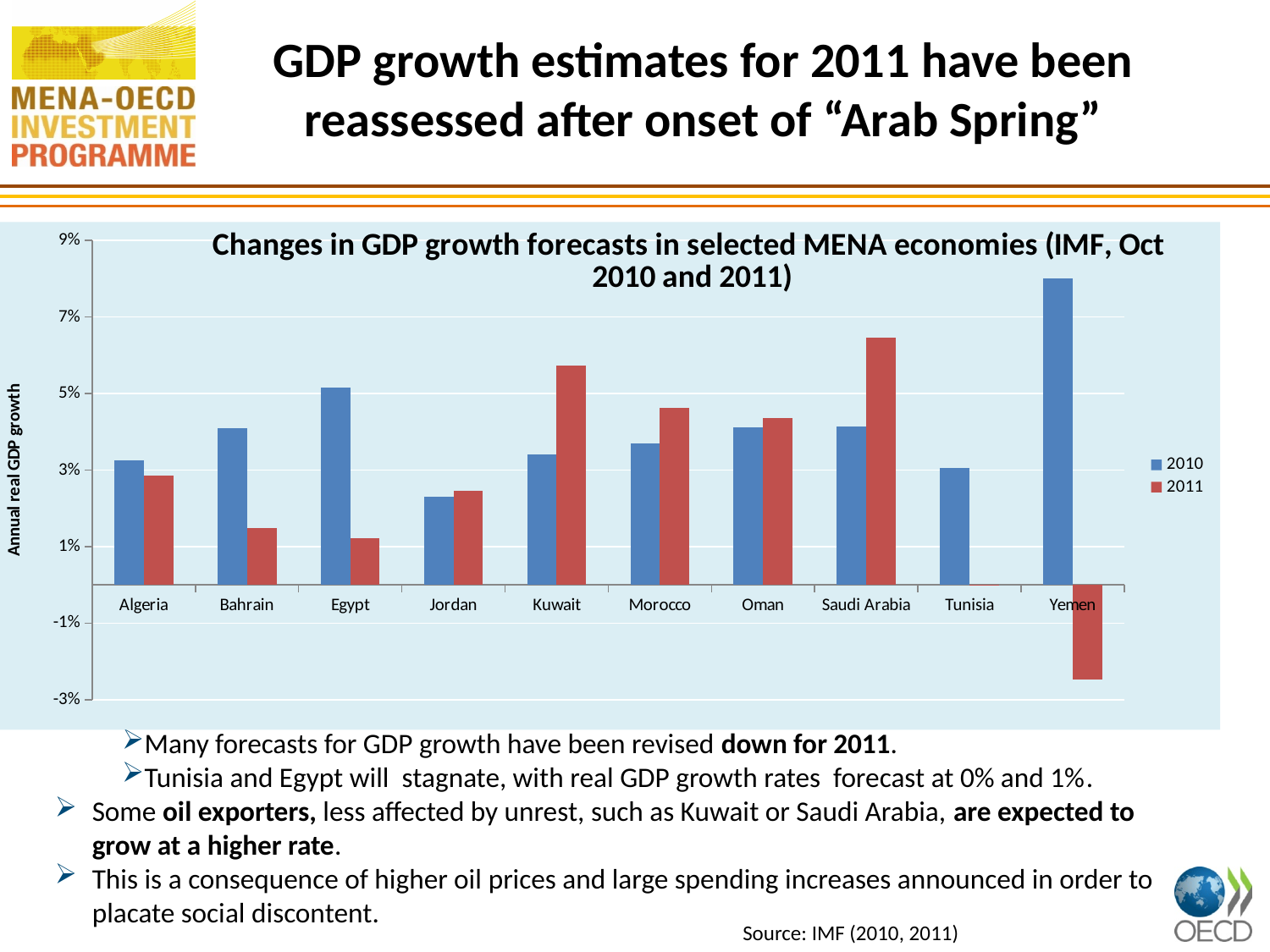
What kind of chart is shown on the slide? Bar chart Is the 2011 value for Egypt greater or less than 3%? less How many countries are shown on the x axis of the chart? 10 Which country has the highest 2011 GDP growth forecast in the chart? Saudi Arabia Which country has the highest 2010 GDP growth forecast in the chart? Yemen What is the title of the chart? Changes in GDP growth forecasts in selected MENA economies (IMF, Oct 2010 and 2011) Which country has the lowest 2011 GDP growth forecast in the chart? Yemen Is the 2011 value for Yemen greater or less than -1%? less Is the 2010 value for Yemen greater or less than 7%? greater For Egypt, which is larger: the 2010 forecast or the 2011 forecast? 2010 How many series does the chart's legend list? 2